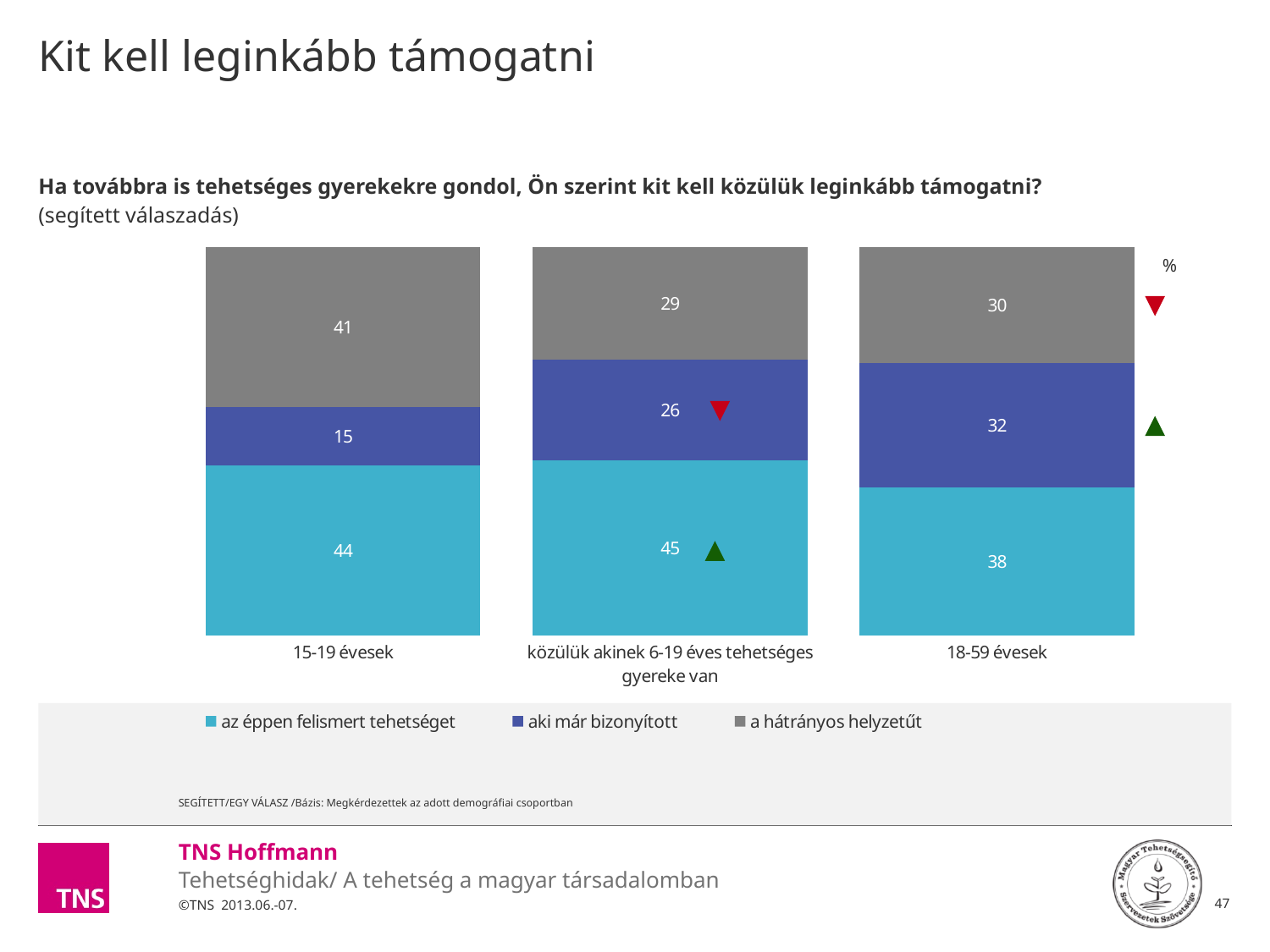
How many series does the legend list? 3 What is the value for "aki már bizonyított" in the "18-59 évesek" category? 32 What is the total of the stacked bar for "18-59 évesek"? 100 What is the difference between the "a hátrányos helyzetűt" values for "15-19 évesek" and "18-59 évesek"? 11 Which category has the lowest value for "az éppen felismert tehetséget"? 18-59 évesek What is the value for "az éppen felismert tehetséget" in the "15-19 évesek" category? 44 Which is larger: the "aki már bizonyított" value for "15-19 évesek" or for "közülük akinek 6-19 éves tehetséges gyereke van"? közülük akinek 6-19 éves tehetséges gyereke van What type of chart is shown on the slide? stacked bar chart Which series is shown in grey in the chart? a hátrányos helyzetűt What is the value for "a hátrányos helyzetűt" in the "közülük akinek 6-19 éves tehetséges gyereke van" category? 29 How many categories are shown on the x axis of the chart? 3 Which category has the highest value for "aki már bizonyított"? 18-59 évesek